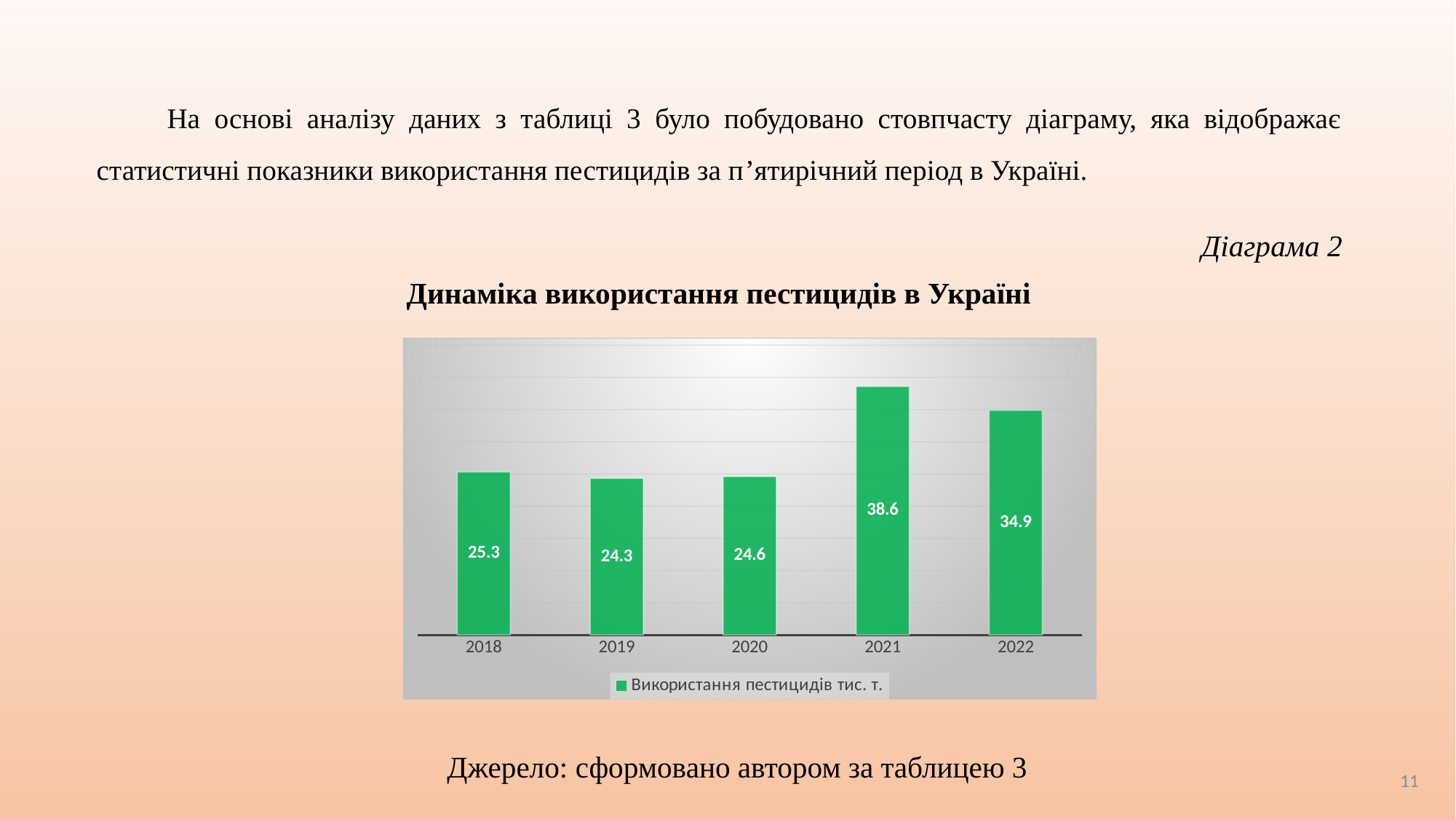
How many years are shown on the x axis? 5 What is the difference between the values for 2021 and 2022? 3.7 What is the value for 2022? 34.9 How many series does the legend list? 1 What is the title of the chart? Динаміка використання пестицидів в Україні Which year has the highest value? 2021 Which year has the lowest value? 2019 What is the difference between the values for 2018 and 2019? 1.0 Which is larger, the value for 2018 or the value for 2020? 2018 What kind of chart is shown? bar chart What is the value for 2018? 25.3 What is the value for 2021? 38.6